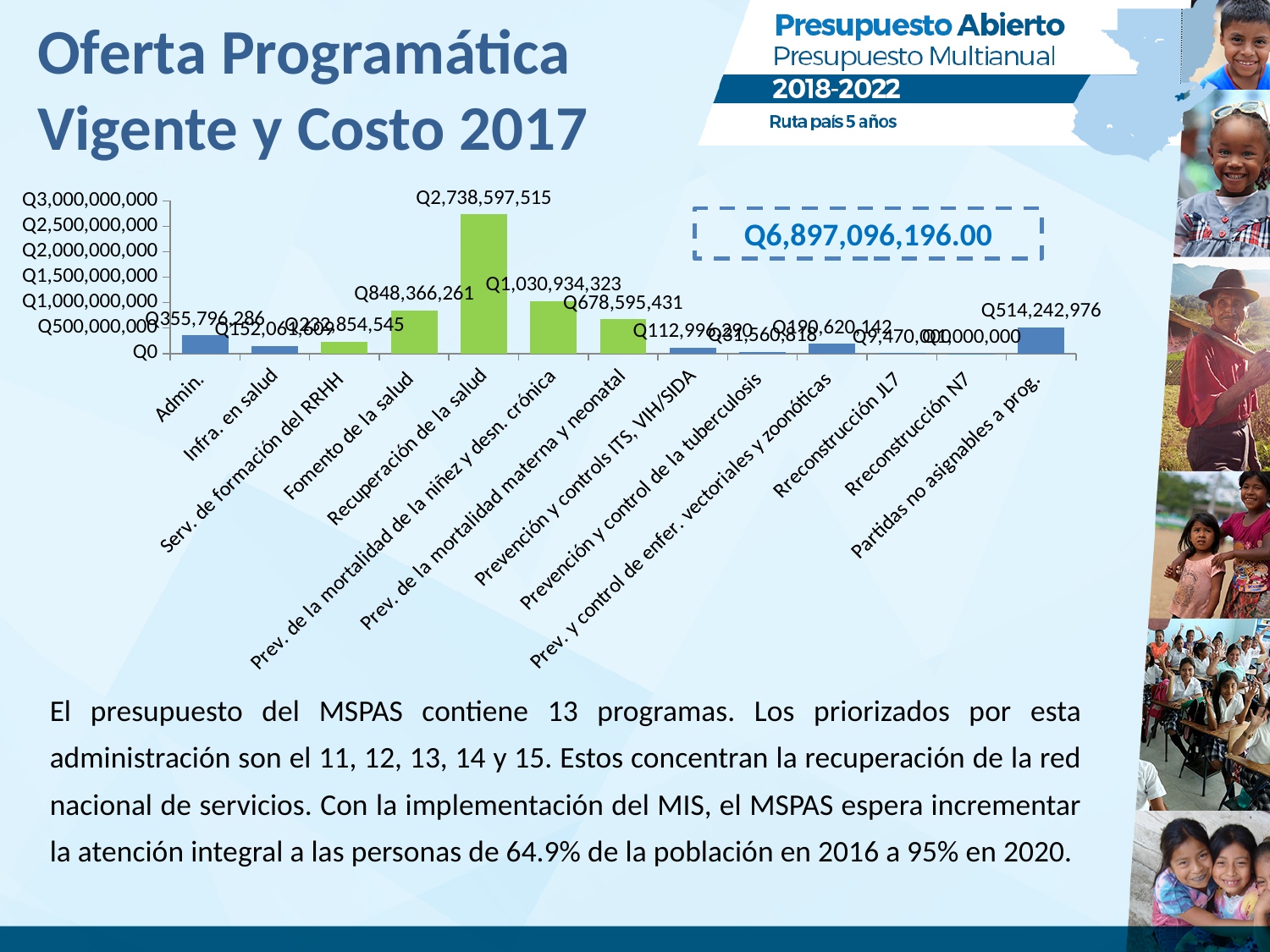
Is the value for Admin. greater or less than Q500,000,000? less What is the difference between Recuperación de la salud and Prev. de la mortalidad de la niñez y desn. crónica? Q1,707,663,192 What is the difference between Fomento de la salud and Prev. de la mortalidad materna y neonatal? Q169,770,830 What is the value for Prev. de la mortalidad de la niñez y desn. crónica? Q1,030,934,323 What total amount is shown in the dashed box above the chart? Q6,897,096,196.00 What is the value for Recuperación de la salud? Q2,738,597,515 What kind of chart is shown on the slide? bar chart Which category has the highest value? Recuperación de la salud Which is larger, Fomento de la salud or Partidas no asignables a prog.? Fomento de la salud What is the value for Fomento de la salud? Q848,366,261 How many categories are shown on the x axis? 13 What is the value for Partidas no asignables a prog.? Q514,242,976